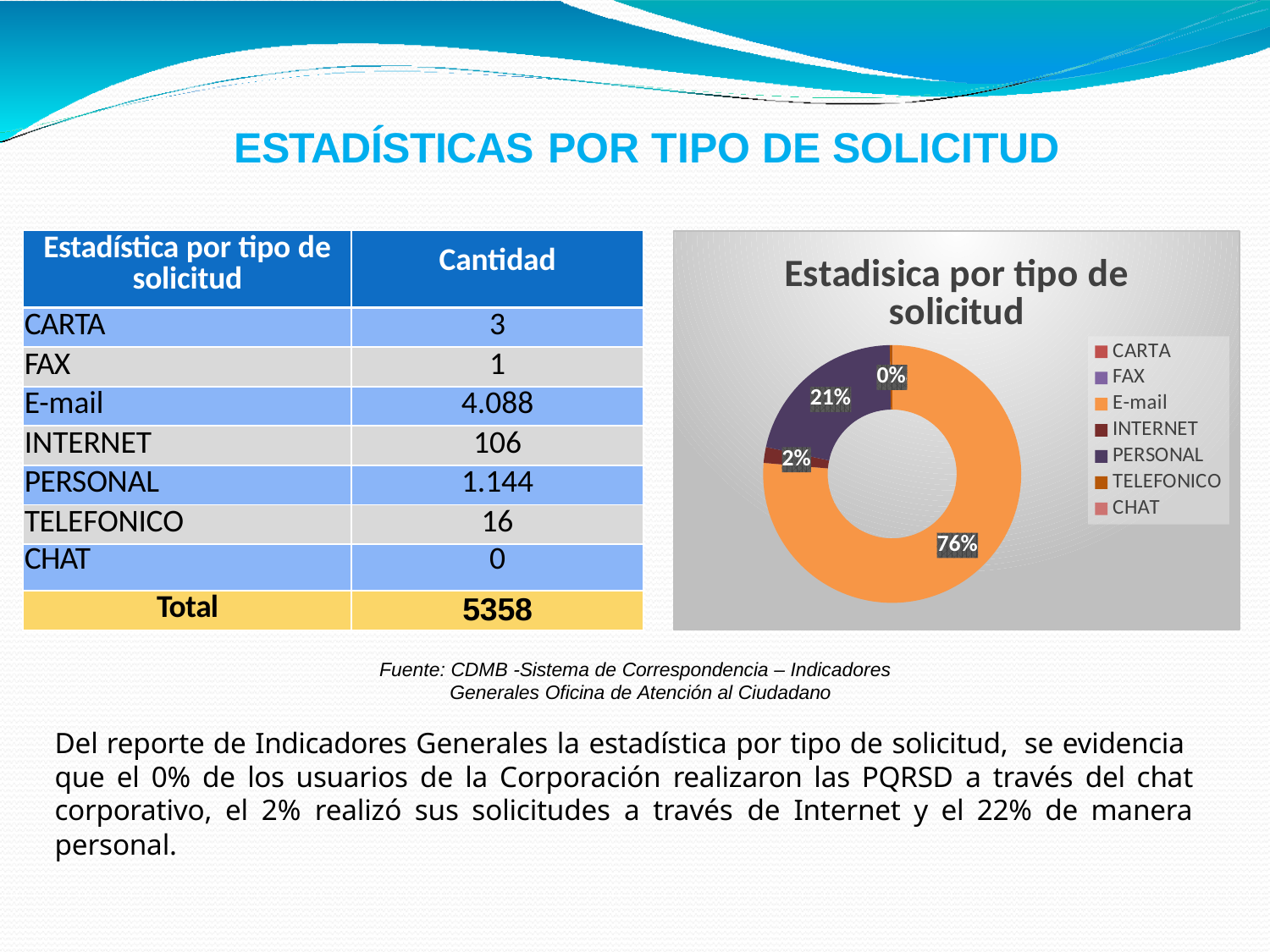
What share of the chart does E-mail represent? 76% How many categories does the chart's legend list? 7 What kind of chart is shown on the slide? doughnut (pie) chart What colour is the E-mail slice in the chart? orange What is the title of the chart? Estadisica por tipo de solicitud By how many percentage points does the E-mail share exceed the PERSONAL share? 55 percentage points Which slice is larger in the chart, PERSONAL or INTERNET? PERSONAL What share of the chart does INTERNET represent? 2% What share of the chart does PERSONAL represent? 21% Which slice is larger in the chart, E-mail or PERSONAL? E-mail Which category has the largest slice in the chart? E-mail